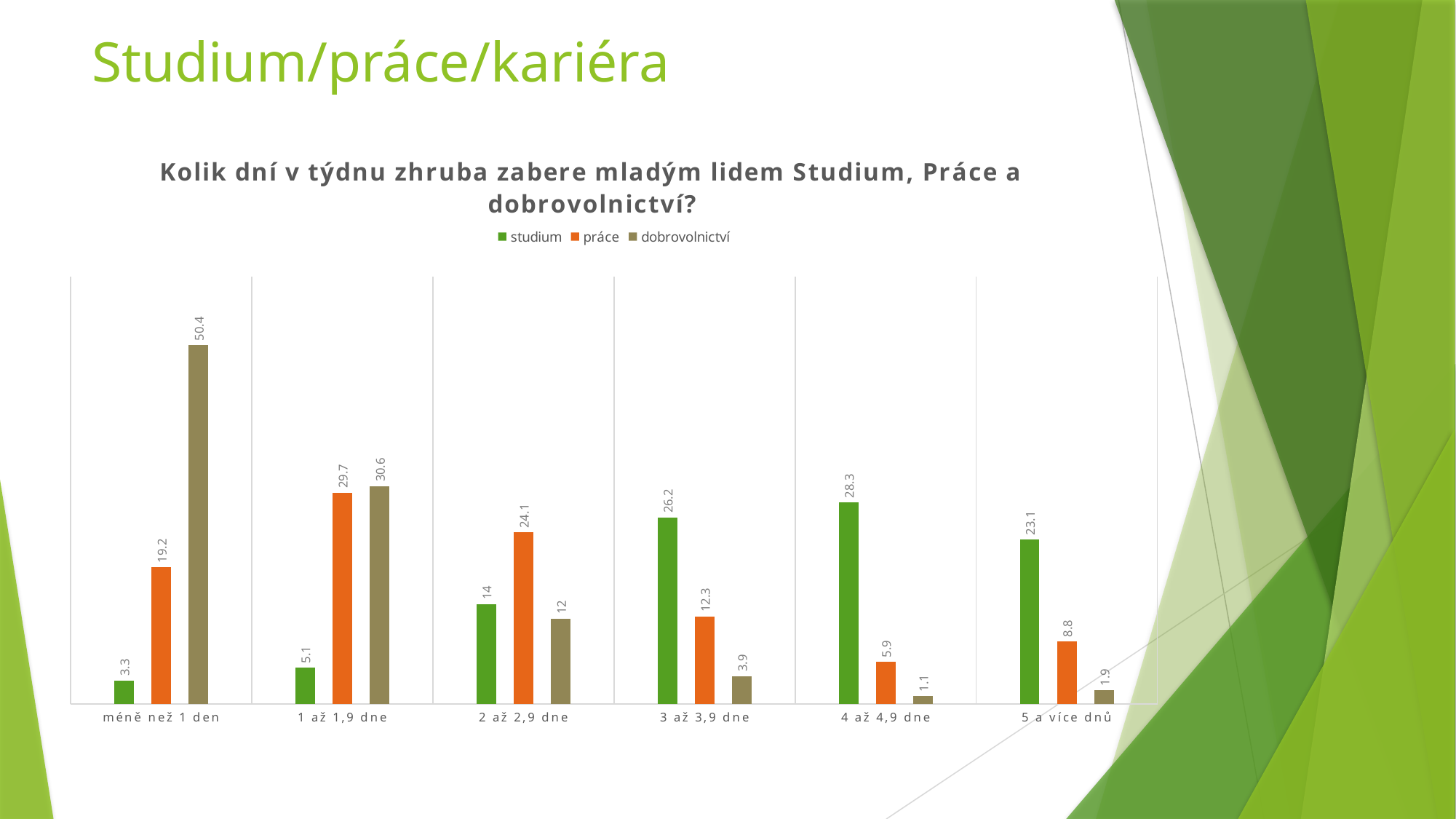
How many categories are shown on the x axis? 6 What is the value for dobrovolnictví in the 'méně než 1 den' category? 50.4 How many series does the legend list? 3 Which category has the highest value for práce? 1 až 1,9 dne In the '3 až 3,9 dne' category, which is larger: studium or práce? studium What is the value for práce in the '2 až 2,9 dne' category? 24.1 Which category has the highest value for studium? 4 až 4,9 dne What is the difference between the práce and studium values in the 'méně než 1 den' category? 15.9 Which colour represents the práce series in the chart? orange What is the value for studium in the '4 až 4,9 dne' category? 28.3 Which category has the lowest value for dobrovolnictví? 4 až 4,9 dne What kind of chart is shown on the slide? bar chart